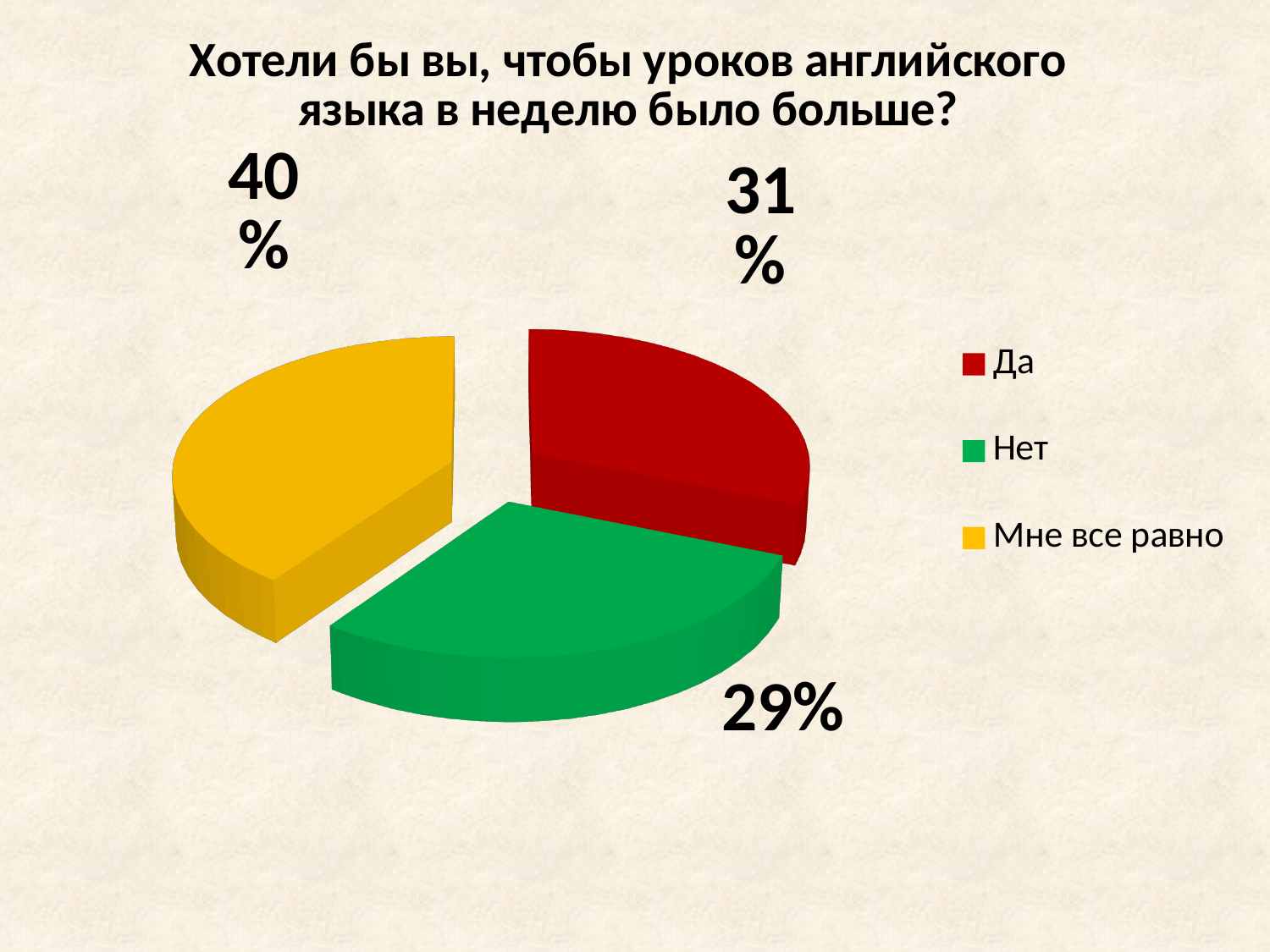
What percentage of respondents answered "Нет"? 29% Which is larger, the share for "Да" or the share for "Нет"? Да What is the difference in percentage points between "Мне все равно" and "Да"? 9 What is the title of the chart? Хотели бы вы, чтобы уроков английского языка в неделю было больше? Which answer has the largest share of the pie? Мне все равно Which answer has the smallest share of the pie? Нет What kind of chart is shown on the slide? Pie chart What percentage of respondents answered "Мне все равно"? 40% How many categories does the pie chart have? 3 What colour represents "Нет" in the chart? Green What percentage of respondents answered "Да"? 31% What is the difference in percentage points between "Да" and "Нет"? 2